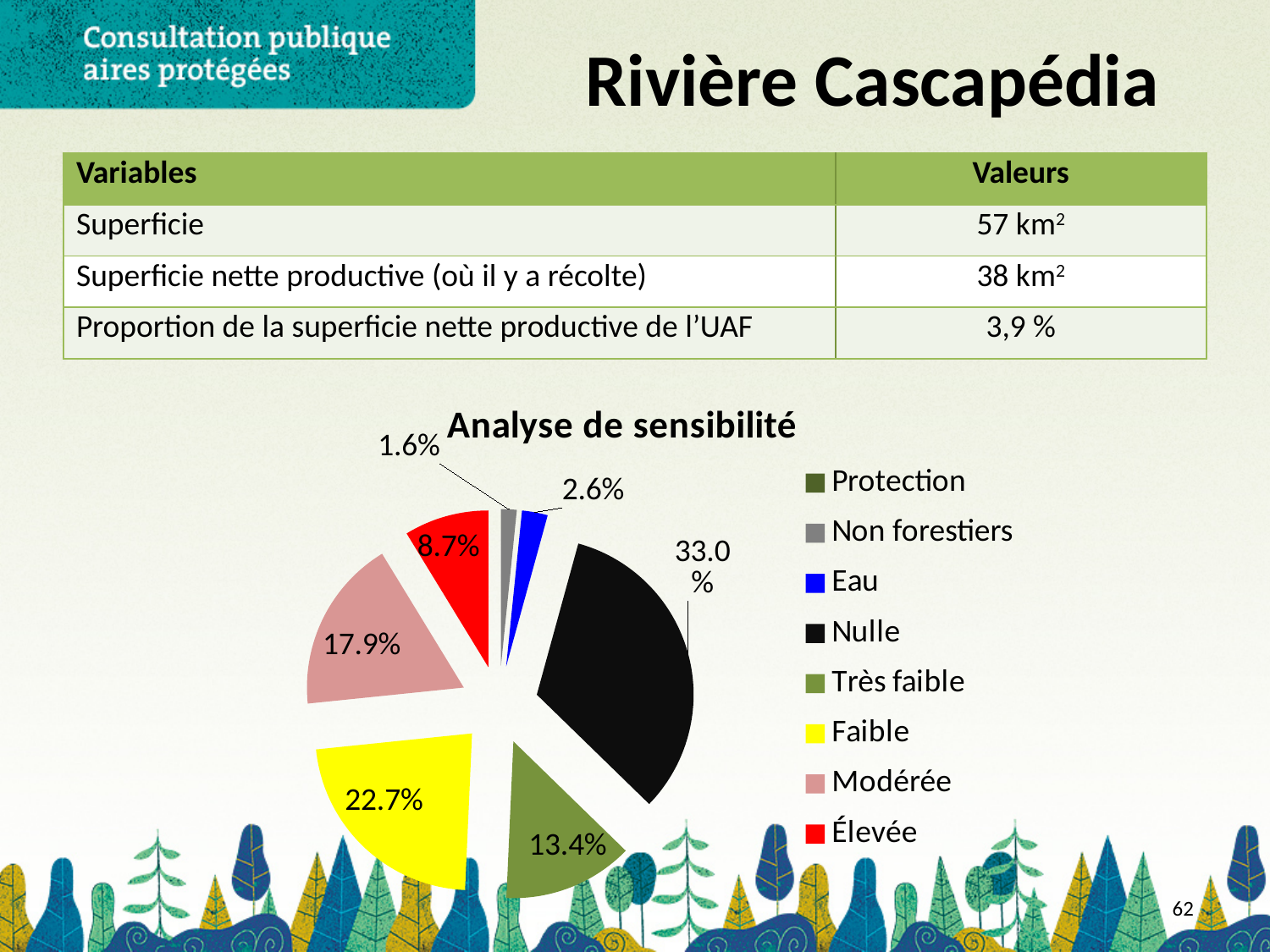
What is the difference between the Faible and Très faible shares in the pie chart? 9.3% What percentage does the Eau slice represent in the pie chart? 2.6% Which is larger in the pie chart, the Modérée share or the Élevée share? Modérée What percentage does the Élevée slice represent in the pie chart? 8.7% What percentage does the Non forestiers slice represent in the pie chart? 1.6% How many entries does the legend of the pie chart list? 8 What percentage does the Faible slice represent in the pie chart? 22.7% What percentage does the Modérée slice represent in the pie chart? 17.9% What percentage does the Nulle slice represent in the pie chart? 33.0% Which category has the largest share of the pie chart? Nulle What kind of chart is shown under the title "Analyse de sensibilité"? pie chart Which labelled slice has the smallest share of the pie chart? Non forestiers